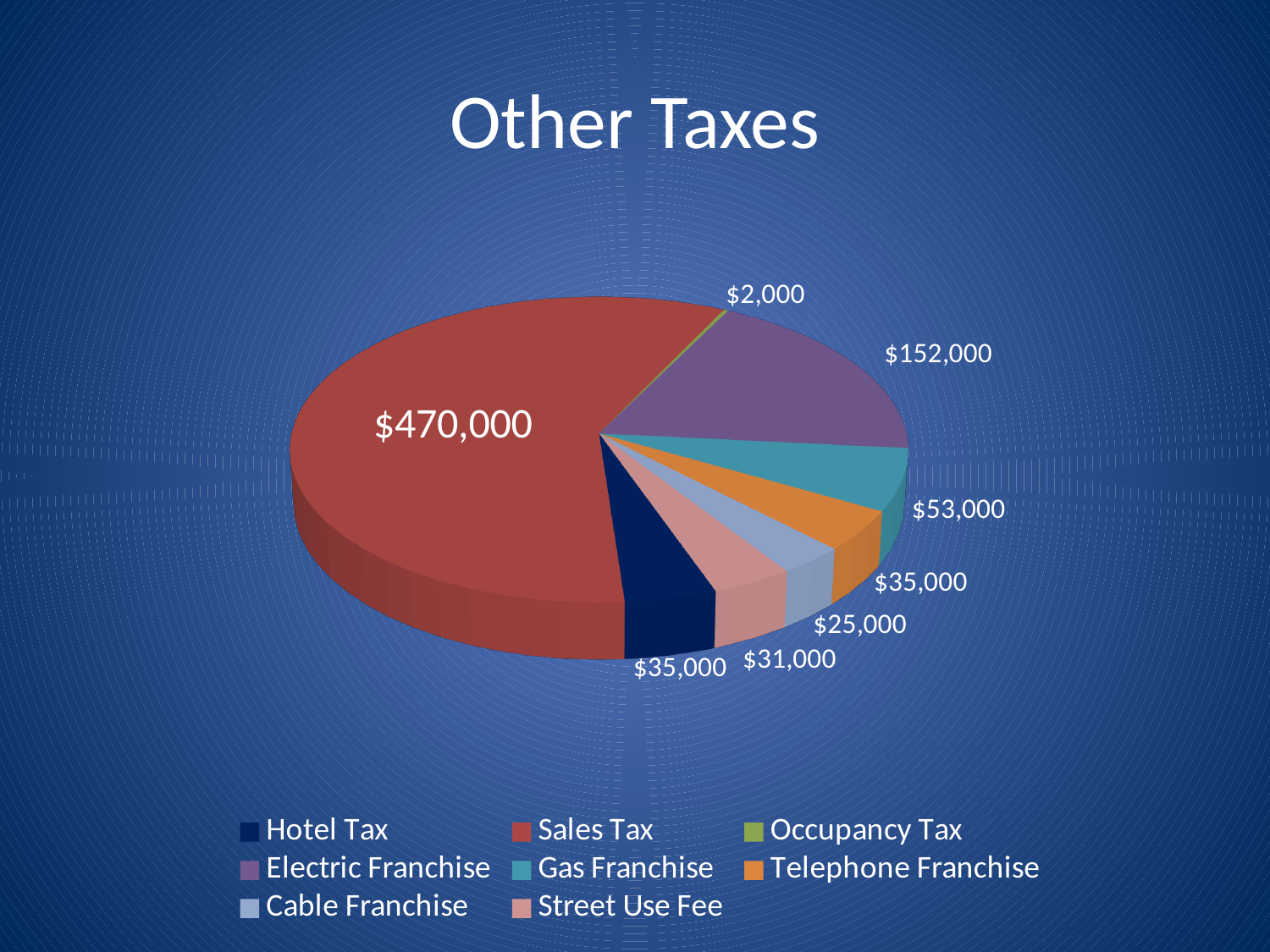
What is the value for Occupancy Tax? $2,000 What is the value for Gas Franchise? $53,000 What is the value for Sales Tax? $470,000 Which is larger, Gas Franchise or Street Use Fee? Gas Franchise Which category has the smallest slice of the pie? Occupancy Tax How many categories does the pie chart show? 8 What is the value for Street Use Fee? $31,000 What is the difference between the Sales Tax value and the Electric Franchise value? $318,000 Which category has the largest slice of the pie? Sales Tax What kind of chart is shown on the slide? pie chart What is the title of the chart? Other Taxes What is the value for Electric Franchise? $152,000